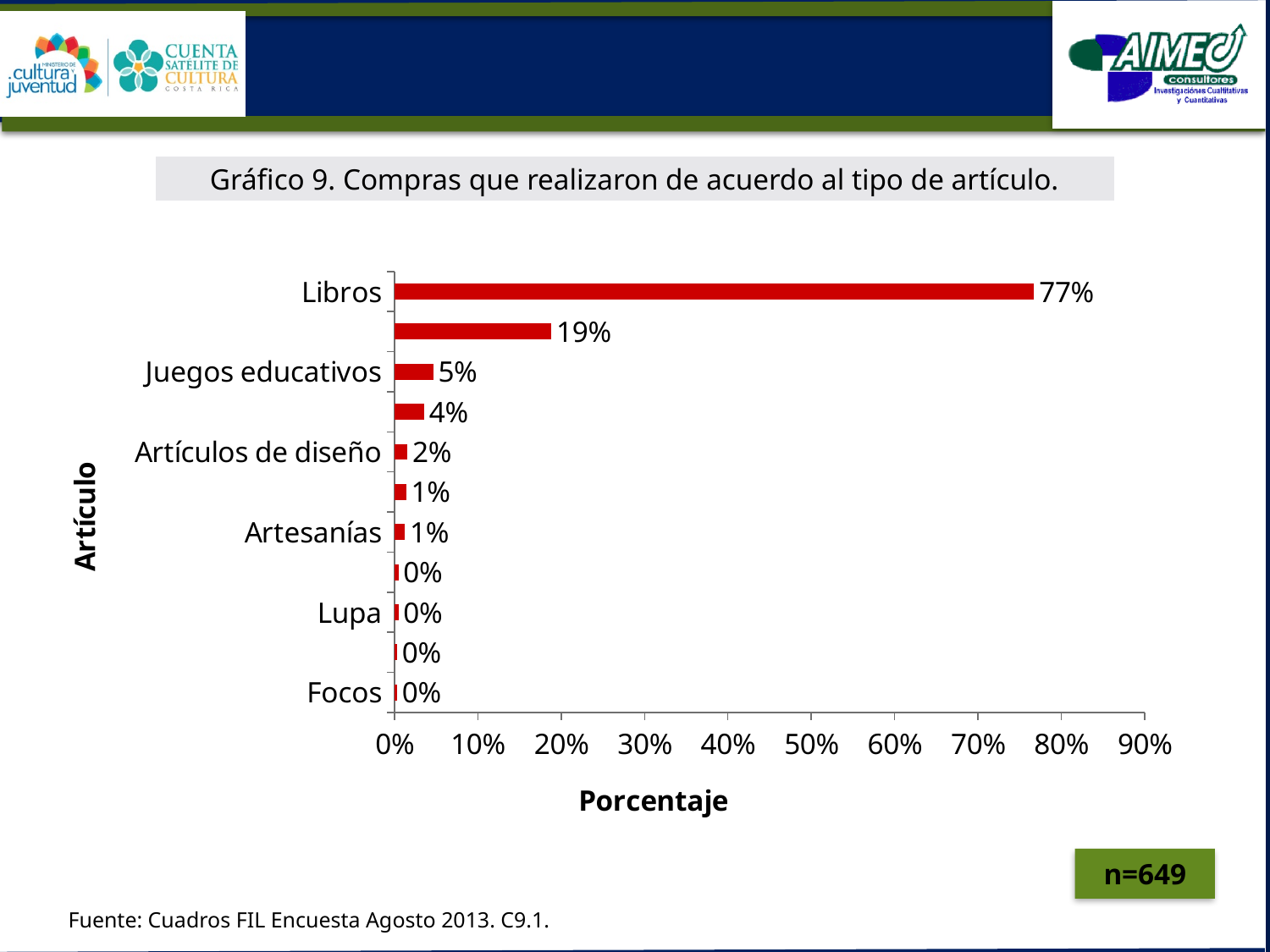
What kind of chart is shown on the slide? bar chart What is the value for Libros? 77% Which is larger, the value for Juegos educativos or the value for Artículos de diseño? Juegos educativos Which category has the highest value? Libros What is the value for Artículos de diseño? 2% What is the value for Lupa? 0% How many bars are plotted in the chart? 11 Is the value for Libros greater or less than 70%? greater What is the value for Artesanías? 1% What is the value for Juegos educativos? 5% What is the title of the chart? Gráfico 9. Compras que realizaron de acuerdo al tipo de artículo. What is the difference between the values for Libros and Juegos educativos? 72%